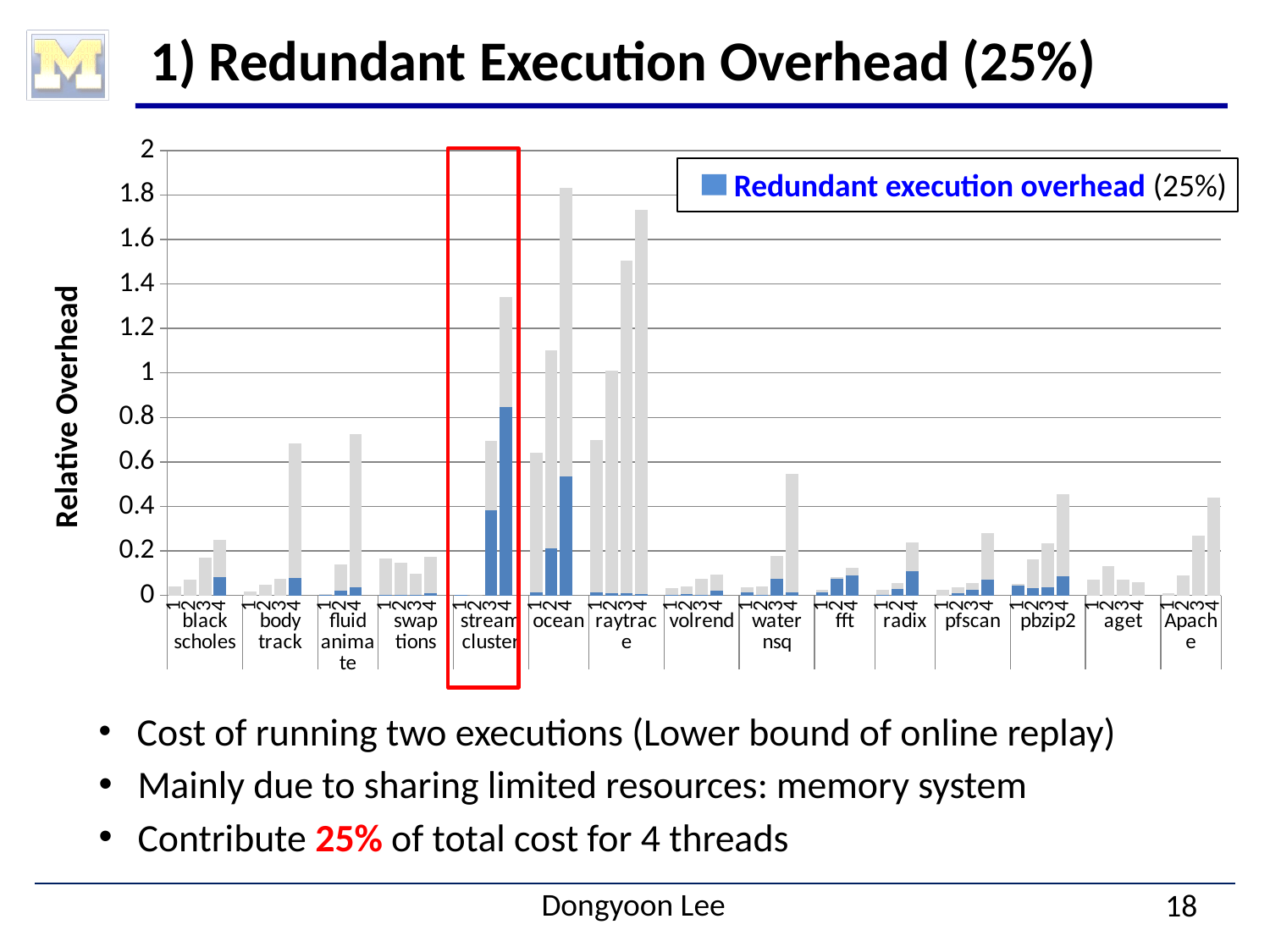
What entry does the chart's legend list? Redundant execution overhead (25%) Is the blue redundant execution overhead portion for streamcluster with 4 threads greater or less than 0.6? greater Is the total bar for raytrace with 4 threads greater or less than 1.6? greater How many benchmark groups are shown along the x axis of the chart? 15 Is the total bar for streamcluster with 4 threads greater or less than 1.2? greater Which is larger, the total bar for raytrace with 4 threads or the total bar for volrend with 4 threads? raytrace with 4 threads Which benchmark has the largest blue redundant execution overhead portion in any of its bars? streamcluster Which benchmark is outlined by the red box in the chart? streamcluster What kind of chart is shown on the slide? bar chart What is the title of the y axis of the chart? Relative Overhead Do the bars for streamcluster rise or fall as the thread count increases from 1 to 4? rise